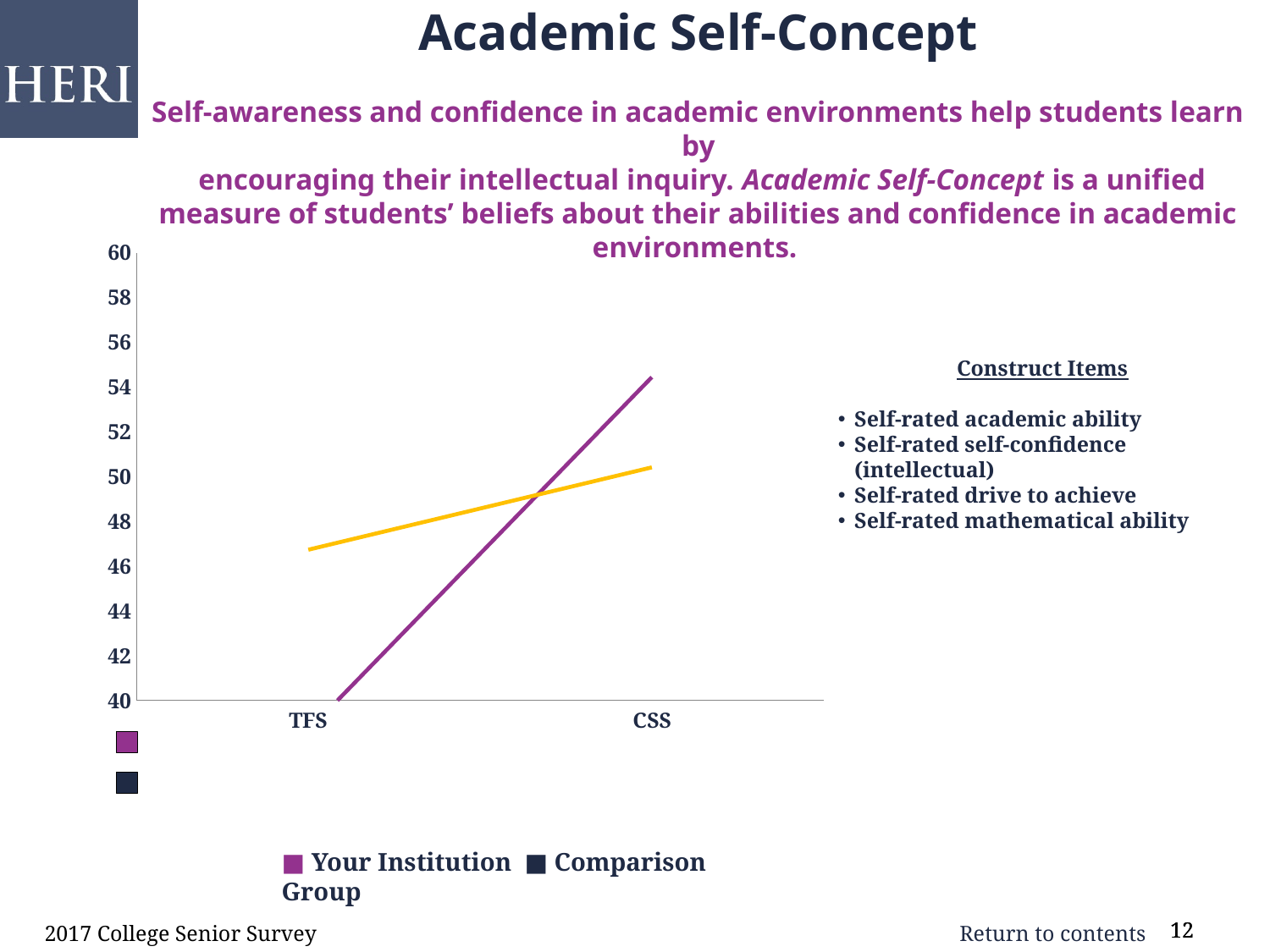
How many categories are shown on the x axis of the chart? 2 What are the two categories on the x axis of the chart? TFS and CSS Is the value for Your Institution at CSS greater or less than 52? greater At CSS, which line is higher: the Your Institution line or the yellow line? Your Institution What kind of chart is shown on the slide? line chart At TFS, which line is higher: the Your Institution line or the yellow line? the yellow line What is the title of the chart on the slide? Academic Self-Concept Does the Your Institution line rise or fall from TFS to CSS? rise Does the yellow line rise or fall from TFS to CSS? rise How many series does the chart legend list? 2 Is the value for Your Institution at TFS greater or less than 42? less Is the value of the yellow line at TFS greater or less than 48? less